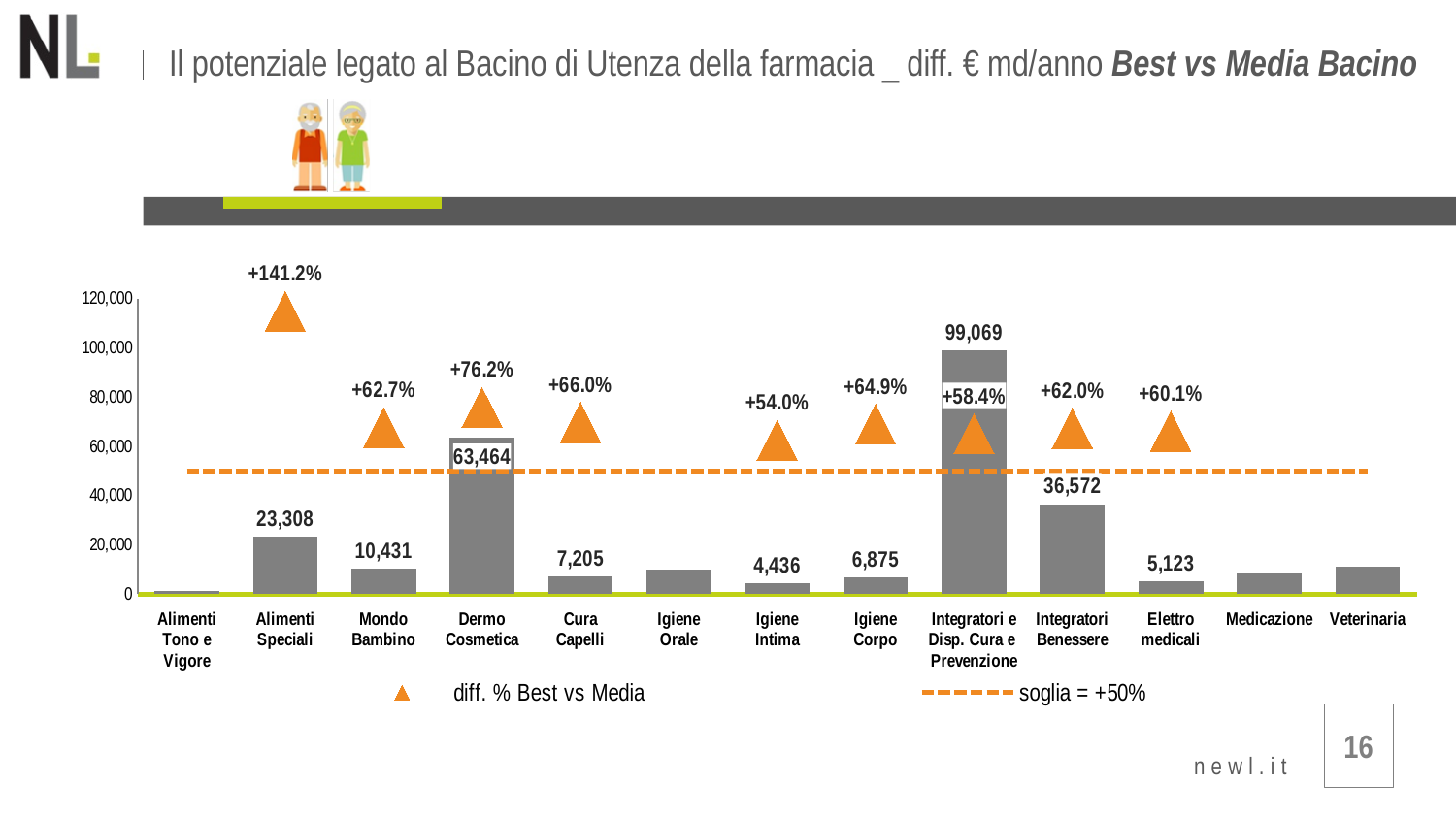
How many categories are shown on the x axis? 13 What kind of chart is shown on the slide? bar chart What is the value shown for Integratori Benessere? 36,572 What is the value shown for Dermo Cosmetica? 63,464 What is the value shown for Integratori e Disp. Cura e Prevenzione? 99,069 Which category has the lowest bar? Alimenti Tono e Vigore Which is larger, the value for Mondo Bambino or the value for Cura Capelli? Mondo Bambino What is the diff. % Best vs Media shown for Alimenti Speciali? +141.2% Is the value for Igiene Orale greater or less than 20,000? less Which category has the highest bar? Integratori e Disp. Cura e Prevenzione What is the difference between the values for Integratori e Disp. Cura e Prevenzione and Dermo Cosmetica? 35,605 What threshold (soglia) does the dashed line in the legend represent? +50%